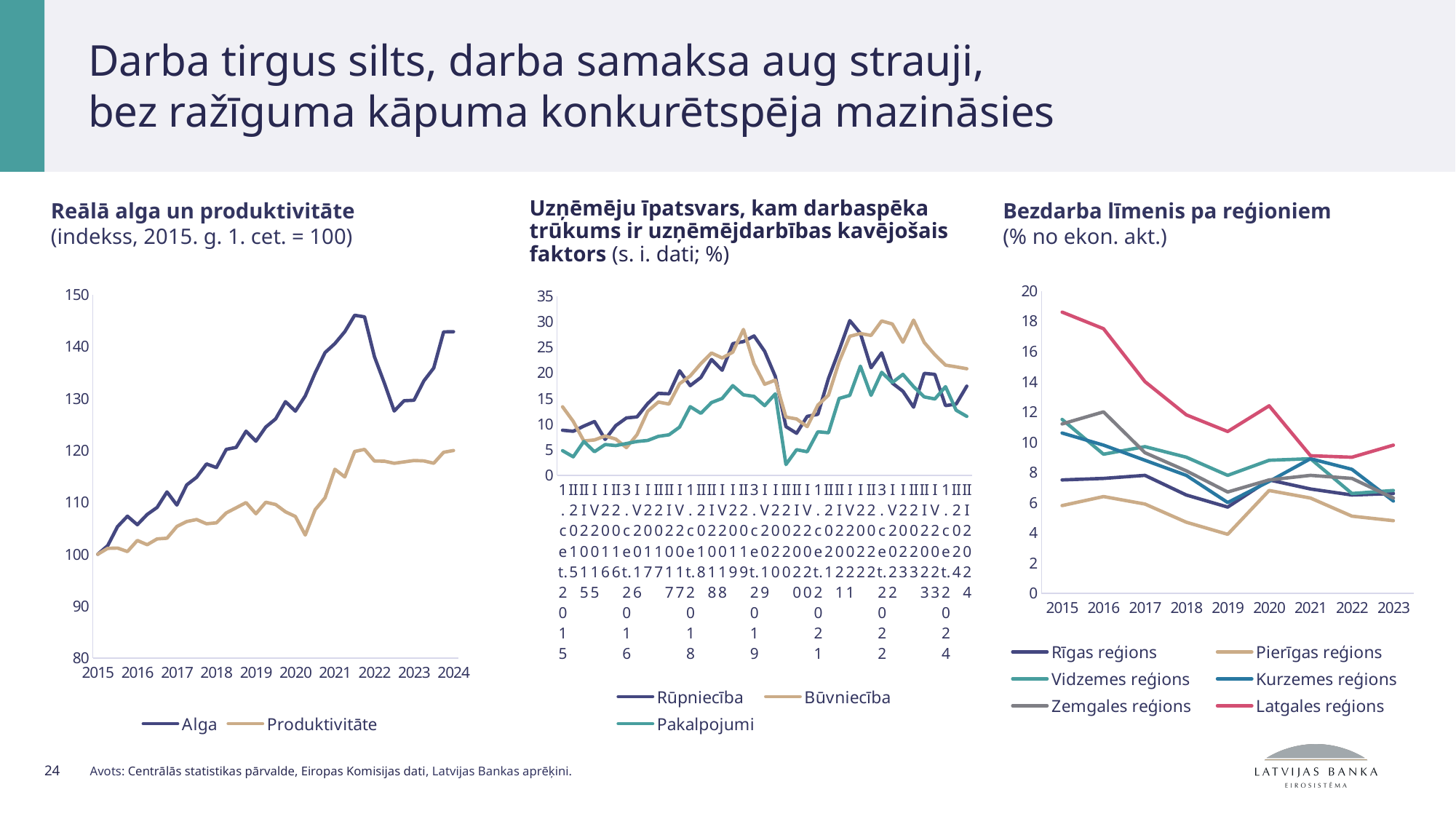
In the right chart "Bezdarba līmenis pa reģioniem", which region has the lowest unemployment rate in 2015? Pierīgas reģions In the middle chart "Uzņēmēju īpatsvars, kam darbaspēka trūkums ir uzņēmējdarbības kavējošais faktors", how many series does the legend list? 3 In the right chart "Bezdarba līmenis pa reģioniem", is the value for Latgales reģions in 2015 greater or less than 16? greater What kind of chart is the left chart titled "Reālā alga un produktivitāte"? line chart In the right chart "Bezdarba līmenis pa reģioniem", which region has the highest unemployment rate in 2015? Latgales reģions In the left chart "Reālā alga un produktivitāte", is the value for Alga in 2024 greater or less than 140? greater In the right chart "Bezdarba līmenis pa reģioniem", how many series does the legend list? 6 In the right chart "Bezdarba līmenis pa reģioniem", how many years are shown on the x axis? 9 In the left chart "Reālā alga un produktivitāte", is the value for Produktivitāte in 2024 greater or less than 130? less In the left chart "Reālā alga un produktivitāte", which series has the higher value in 2024, Alga or Produktivitāte? Alga In the left chart "Reālā alga un produktivitāte", what are the two legend entries? Alga and Produktivitāte In the right chart "Bezdarba līmenis pa reģioniem", does the value for Latgales reģions rise or fall from 2015 to 2023? fall